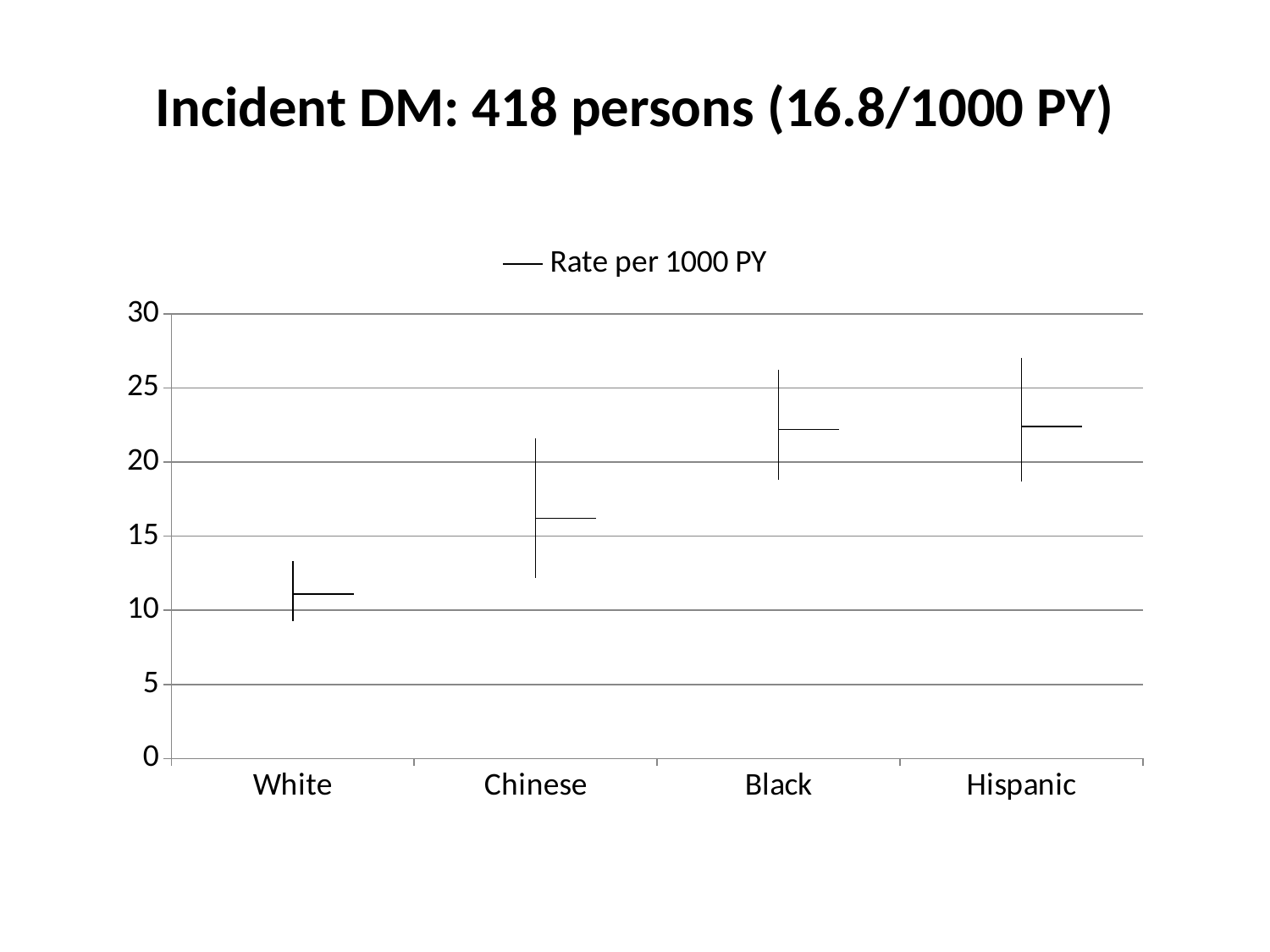
How many series does the chart legend list? 1 Which has a higher rate per 1000 PY, White or Chinese? Chinese Is the value for White greater or less than 15? less Which has a higher rate per 1000 PY, Chinese or Black? Black Is the value for Chinese greater or less than 20? less What is the title of the slide containing the chart? Incident DM: 418 persons (16.8/1000 PY) How many categories are shown on the x axis of the chart? 4 Do the values generally rise or fall moving from White to Hispanic along the x axis? rise What is the name of the series shown in the chart legend? Rate per 1000 PY Is the value for Hispanic greater or less than 20? greater Which category has the lowest rate per 1000 PY? White